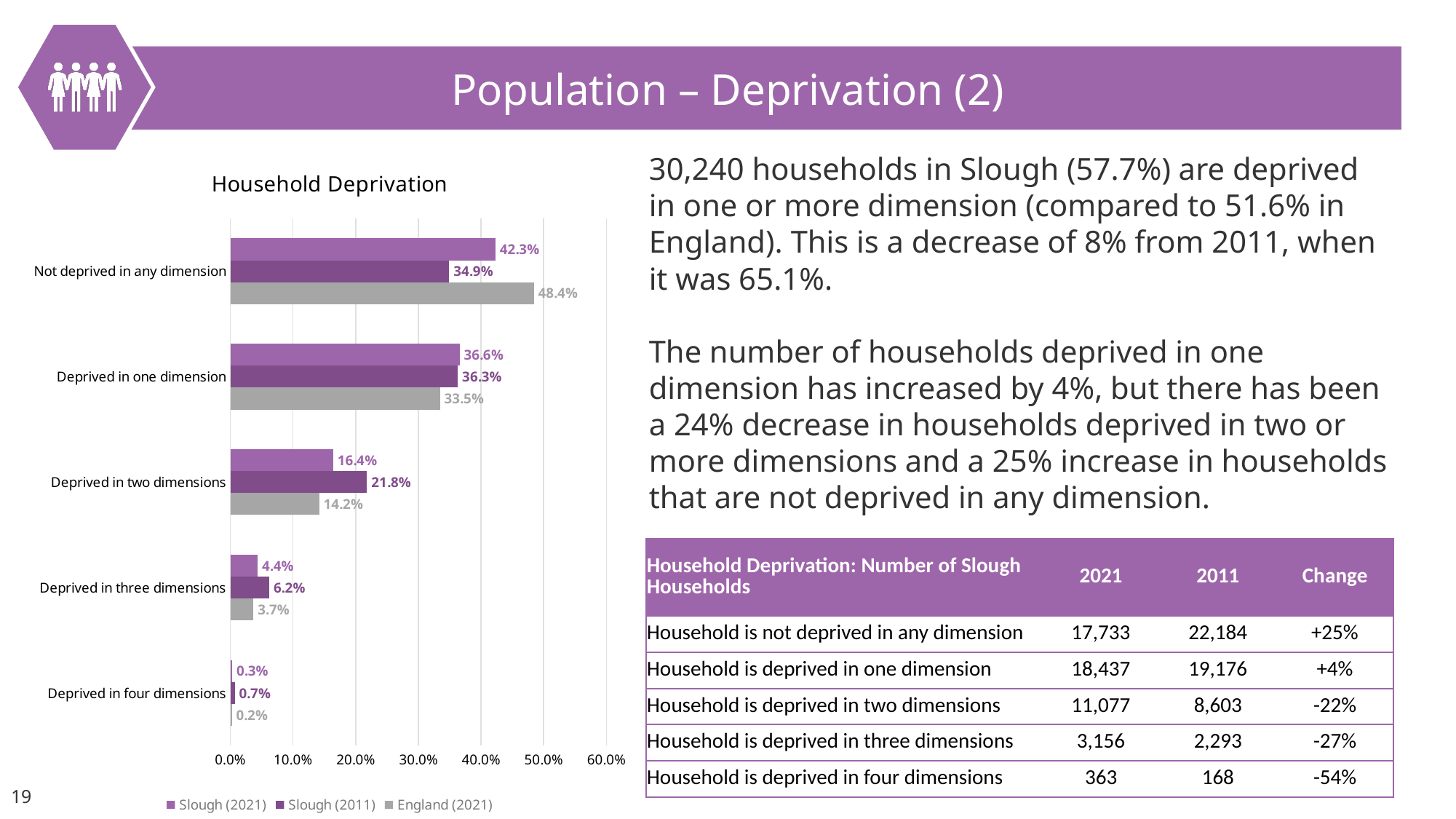
What is the England (2021) value for 'Deprived in two dimensions'? 14.2% Which is larger for 'Not deprived in any dimension': Slough (2021) or England (2021)? England (2021) What is the title of the chart? Household Deprivation What is the difference between the Slough (2011) and Slough (2021) values for 'Deprived in two dimensions'? 5.4% How many categories are shown on the chart? 5 What is the Slough (2021) value for 'Not deprived in any dimension'? 42.3% Which category has the highest Slough (2011) value? Deprived in one dimension Which category has the lowest England (2021) value? Deprived in four dimensions How many series does the legend list? 3 What kind of chart is shown? Bar chart Is the Slough (2021) value for 'Deprived in one dimension' greater or less than 30.0%? greater What is the Slough (2011) value for 'Deprived in three dimensions'? 6.2%